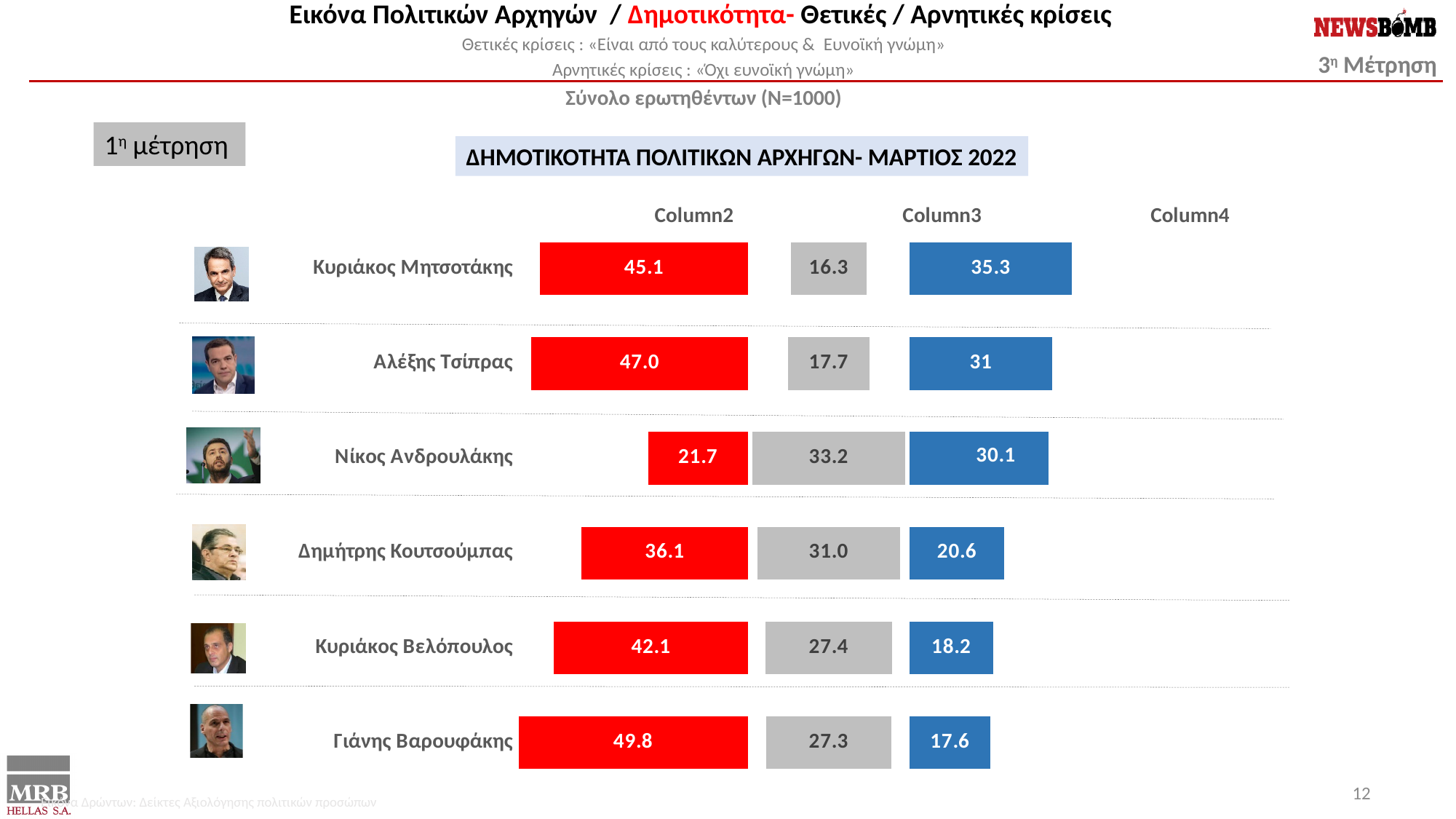
What kind of chart is shown on the slide? Stacked bar chart How many politicians are shown in the chart? 6 What is the title of the chart? ΔΗΜΟΤΙΚΟΤΗΤΑ ΠΟΛΙΤΙΚΩΝ ΑΡΧΗΓΩΝ- ΜΑΡΤΙΟΣ 2022 What is the difference between the blue (Column4) values for Κυριάκος Μητσοτάκης and Κυριάκος Βελόπουλος? 17.1 How many series (columns) does the chart show for each politician? 3 Which politician has the highest red (Column2) value? Γιάνης Βαρουφάκης Who has the larger red (Column2) value, Αλέξης Τσίπρας or Κυριάκος Μητσοτάκης? Αλέξης Τσίπρας What is the total of the three stacked values for Κυριάκος Μητσοτάκης? 96.7 What is the grey (Column3) value for Νίκος Ανδρουλάκης? 33.2 What is the blue (Column4) value for Αλέξης Τσίπρας? 31 What is the red (Column2) value for Κυριάκος Μητσοτάκης? 45.1 Which politician has the lowest blue (Column4) value? Γιάνης Βαρουφάκης